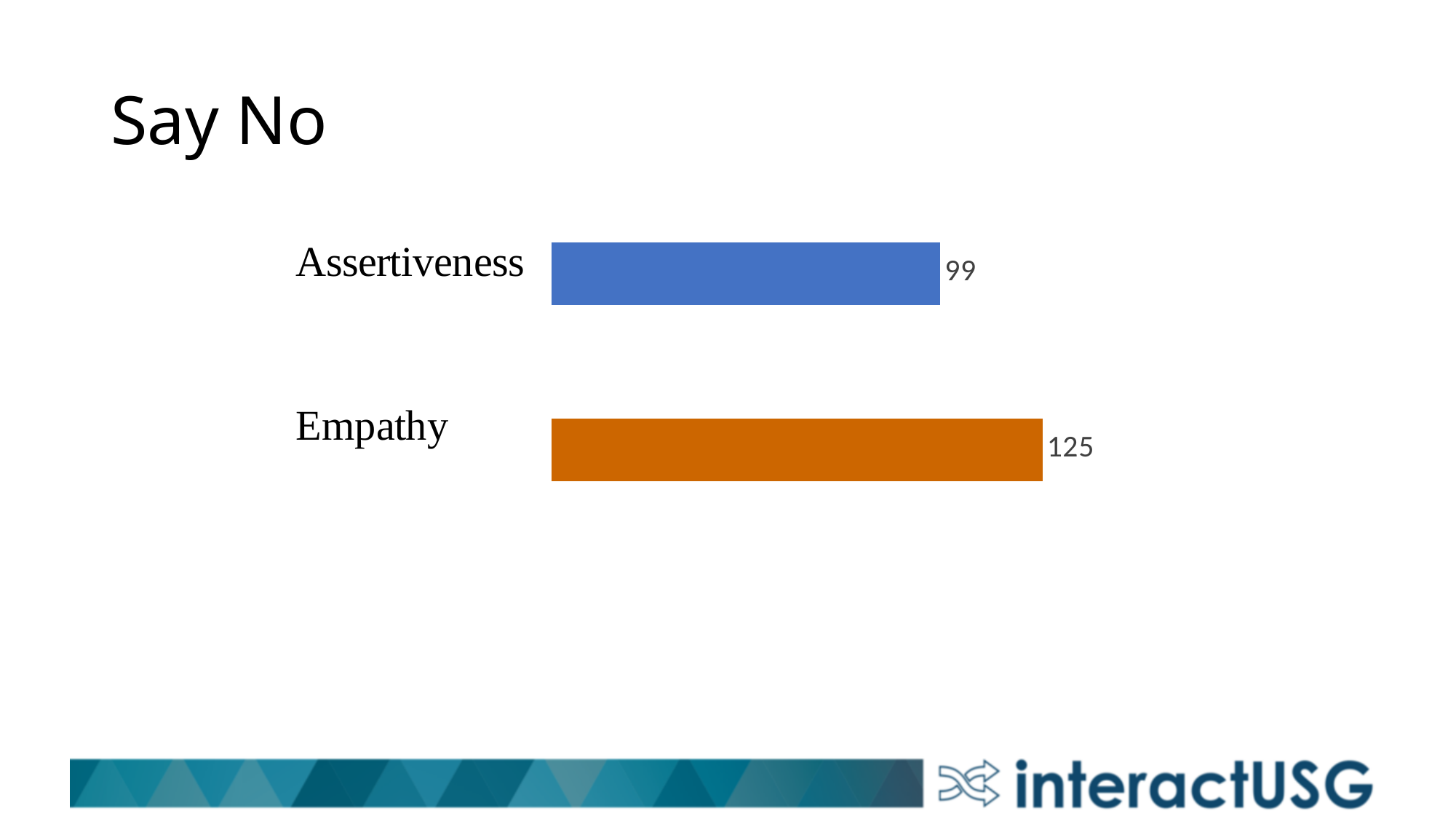
Which category has the highest value? Empathy What kind of chart is shown on the slide? Bar chart What is the value for Empathy? 125 How many categories are shown in the chart? 2 Which is larger, the value for Assertiveness or the value for Empathy? Empathy What is the value for Assertiveness? 99 What is the difference between the values for Empathy and Assertiveness? 26 What colour is the bar for Empathy? Orange What is the title of the slide containing the chart? Say No Which category has the lowest value? Assertiveness